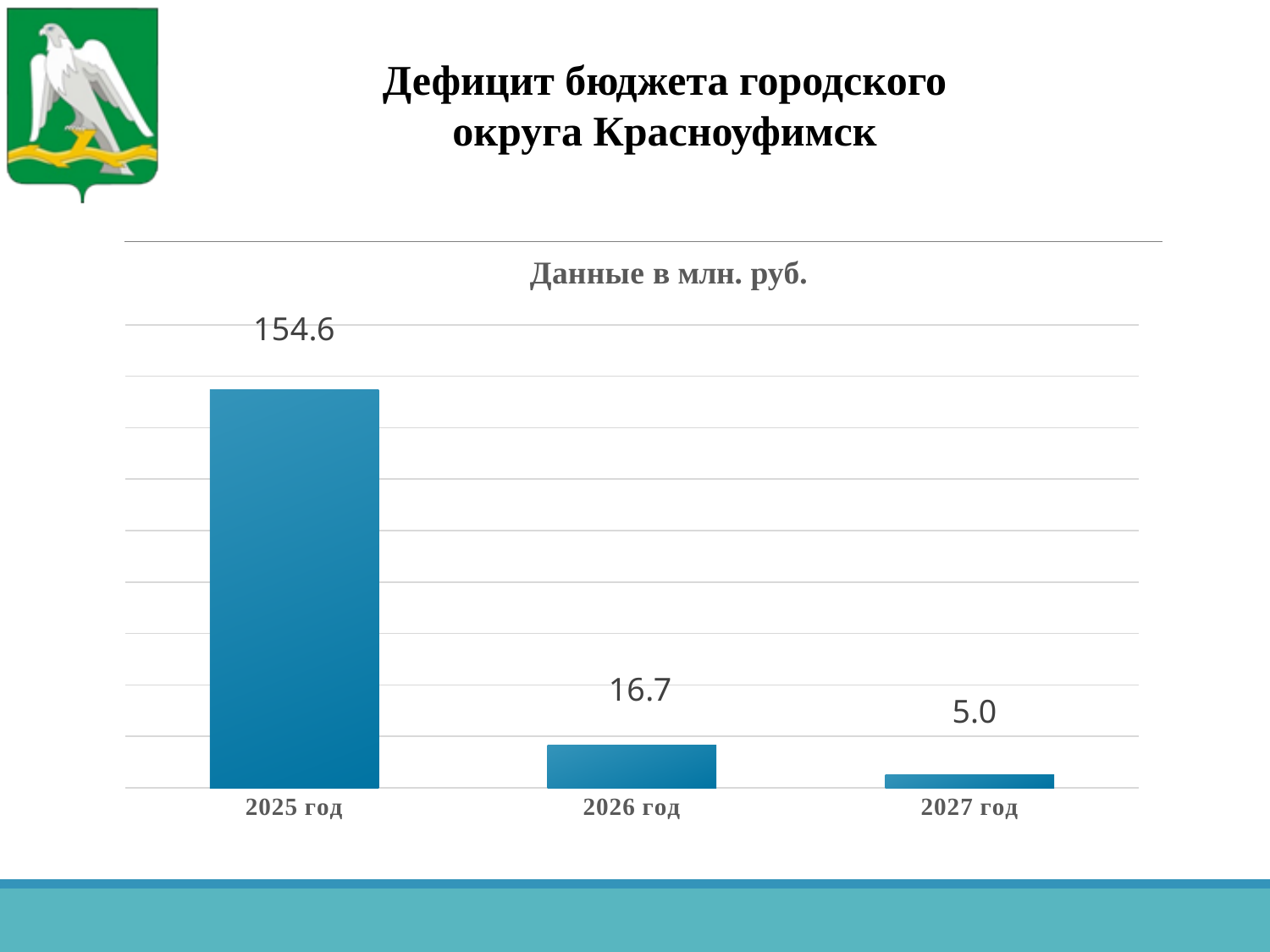
What is the difference between the deficit for 2026 год and 2027 год? 11.7 What kind of chart is shown on the slide? Bar chart Which year has the lowest budget deficit? 2027 год What is the budget deficit value for 2025 год? 154.6 Do the deficit values rise or fall from 2025 год to 2027 год? Fall Which year has the highest budget deficit? 2025 год What is the difference between the deficit for 2025 год and 2026 год? 137.9 What is the budget deficit value for 2027 год? 5.0 What is the budget deficit value for 2026 год? 16.7 How many years are shown on the chart? 3 What is the chart's title? Данные в млн. руб. Which is larger, the deficit for 2026 год or 2027 год? 2026 год